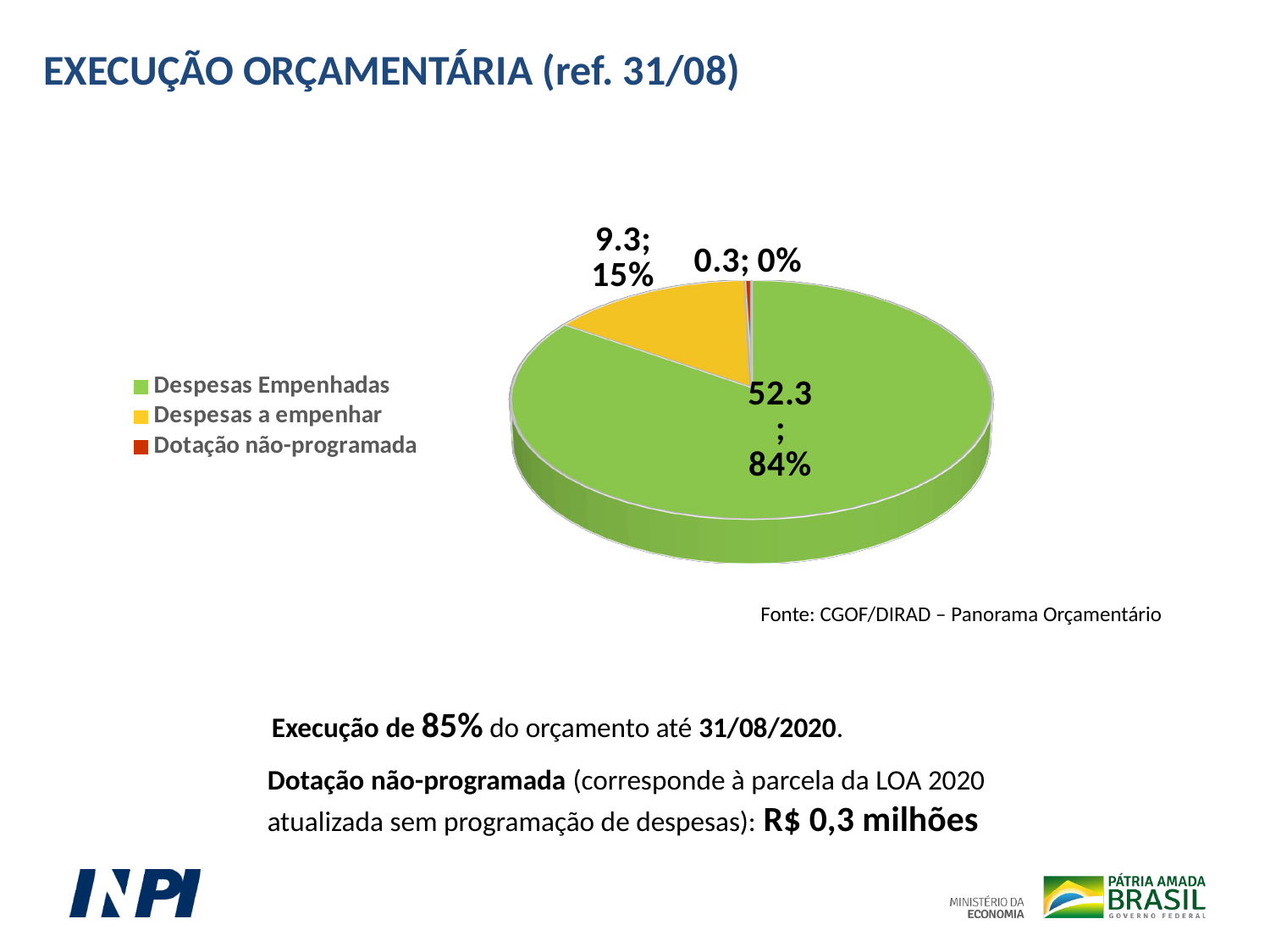
Which category has the largest slice of the pie? Despesas Empenhadas What value is labelled on the Despesas a empenhar slice? 9.3 What value is labelled on the Dotação não-programada slice? 0.3 How many entries does the legend of the pie chart list? 3 Which category has the smallest slice of the pie? Dotação não-programada Which colour represents Despesas a empenhar in the pie chart? yellow What value is labelled on the Despesas Empenhadas slice? 52.3 What is the difference between the values for Despesas Empenhadas and Despesas a empenhar? 43 What share of the pie does Despesas Empenhadas represent? 84% What share of the pie does Despesas a empenhar represent? 15% How many slices does the pie chart have? 3 What kind of chart is shown on the slide? pie chart